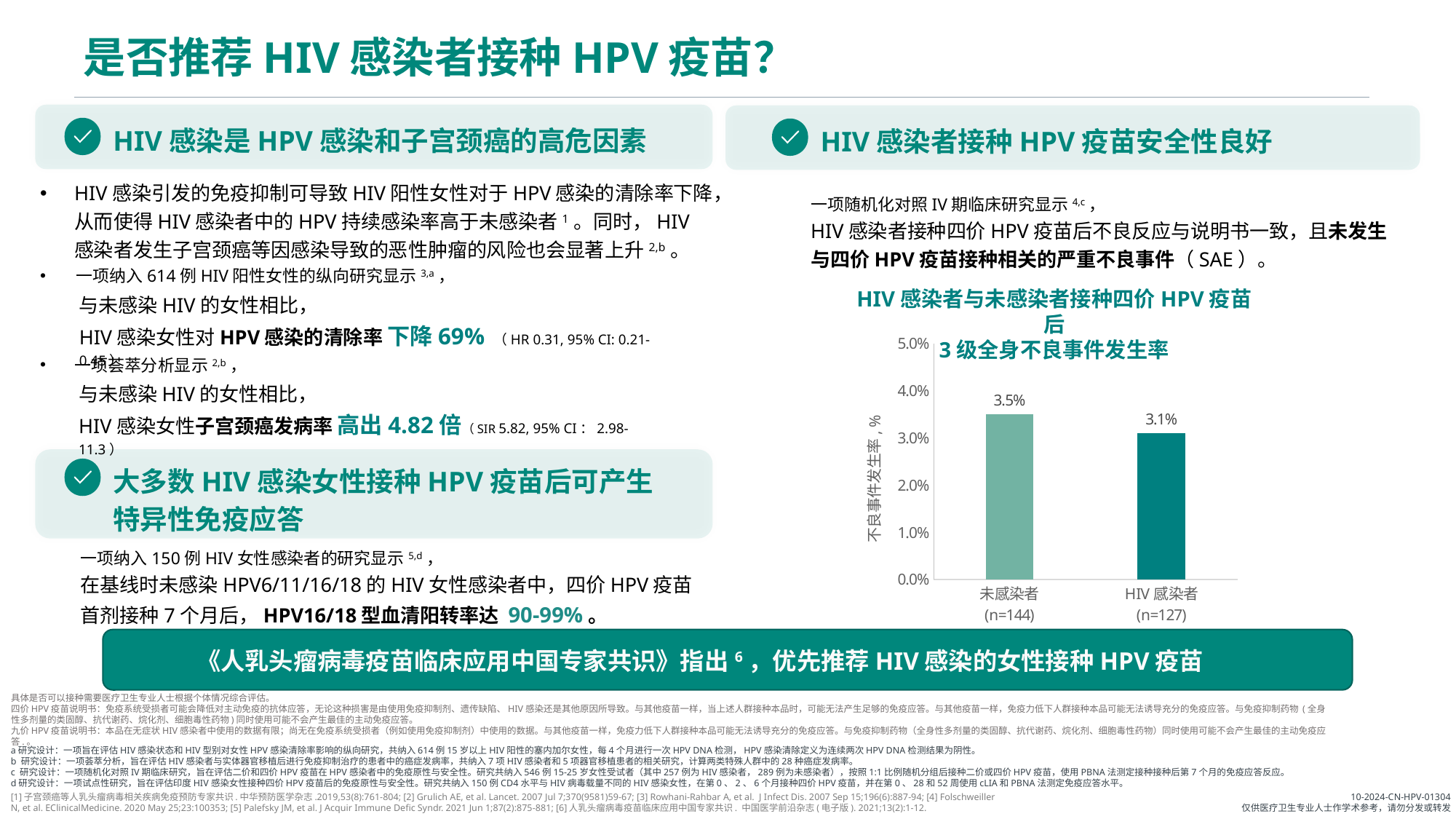
What is the maximum value shown on the chart's y axis? 5.0% What is the difference between the adverse event rates of 未感染者 and HIV 感染者? 0.4% Which group has the lower adverse event rate in the chart? HIV 感染者 What is the grade 3 systemic adverse event rate for HIV 感染者 in the chart? 3.1% What is the sample size (n) shown for the HIV 感染者 group in the chart? n=127 Is the adverse event rate for 未感染者 greater or less than 4.0%? less What type of chart is shown on the slide? Bar chart Is the adverse event rate for HIV 感染者 greater or less than 3.0%? greater What is the grade 3 systemic adverse event rate for 未感染者 in the chart? 3.5% Which group has the higher adverse event rate in the chart? 未感染者 How many groups are plotted in the chart? 2